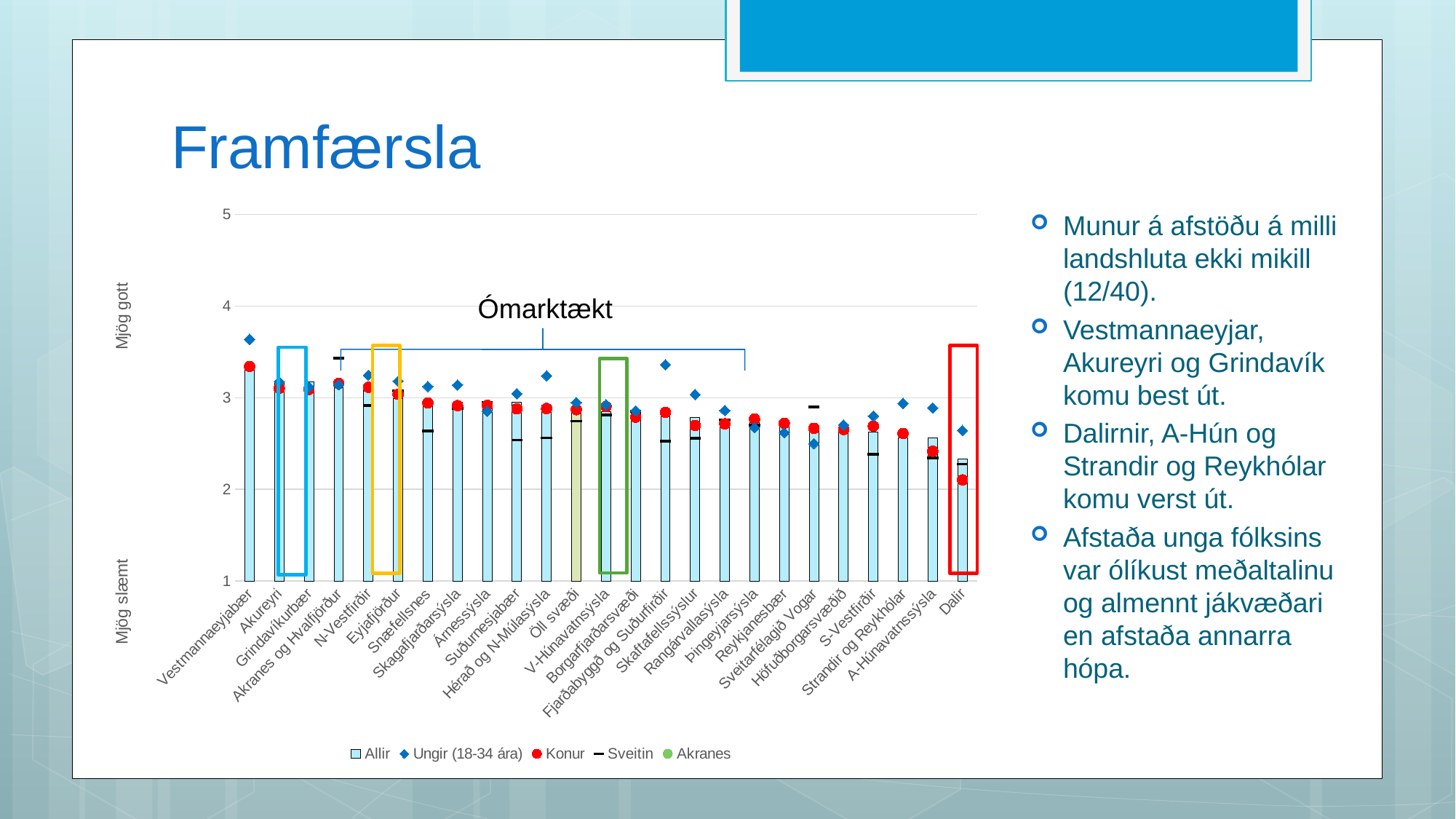
Which has the larger 'Allir' value, Akureyri or Dalir? Akureyri What is the title of the chart on the slide? Framfærsla What label is shown at the top of the y axis of the chart? Mjög gott How many categories are shown along the x axis of the chart? 25 Do the 'Allir' bars generally rise or fall from left to right along the x axis? fall Which category has the highest 'Allir' bar? Vestmannaeyjabær Is the 'Allir' value for Vestmannaeyjabær greater or less than 3? greater What kind of chart is shown on the slide? bar chart Which category has the lowest 'Allir' bar? Dalir How many series does the chart's legend list? 5 Is the 'Konur' value for Dalir greater or less than 3? less Is the 'Allir' value for Dalir greater or less than 3? less